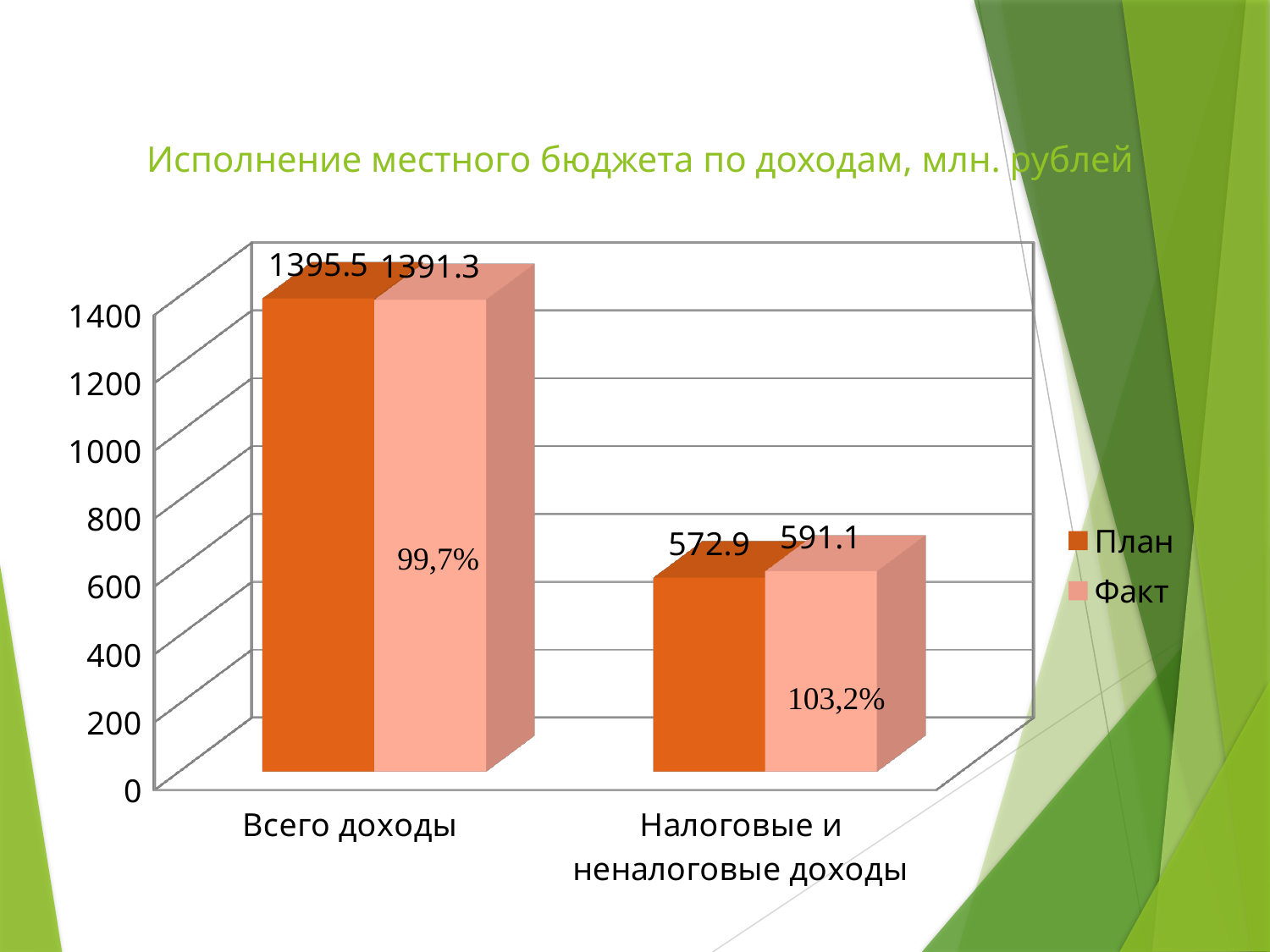
For Налоговые и неналоговые доходы, which is larger: План or Факт? Факт Is the Факт value for Всего доходы greater or less than 1200? greater Which category has the highest Факт value? Всего доходы What is the План value for Всего доходы? 1395.5 How many series does the legend list? 2 Which category has the lowest План value? Налоговые и неналоговые доходы What kind of chart is shown on the slide? bar chart What is the Факт value for Всего доходы? 1391.3 What is the difference between the План and Факт values for Налоговые и неналоговые доходы? 18.2 What is the Факт value for Налоговые и неналоговые доходы? 591.1 What is the План value for Налоговые и неналоговые доходы? 572.9 How many categories are shown on the x axis? 2